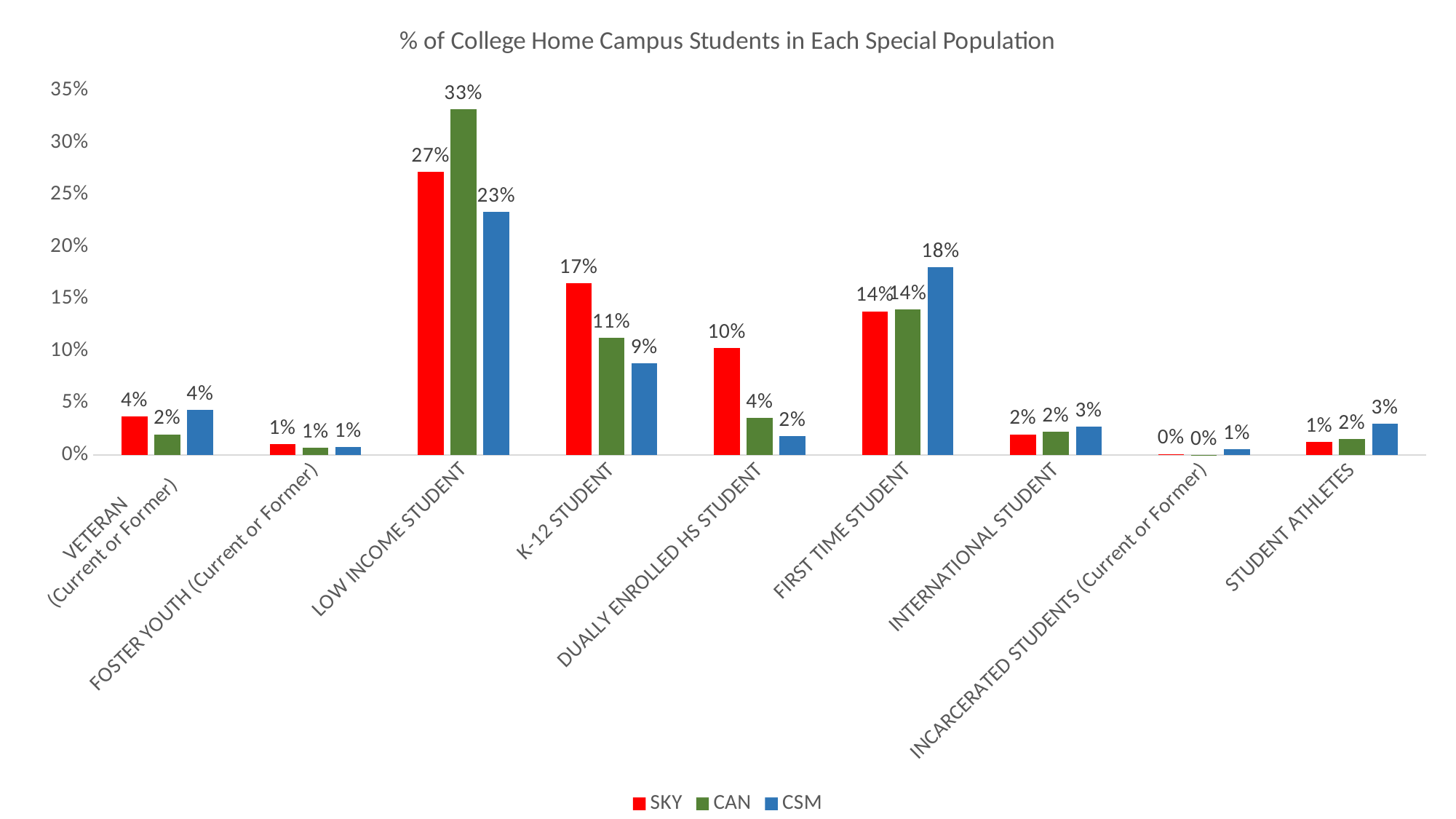
What is the difference between the CAN and CSM values for LOW INCOME STUDENT? 10% What is the SKY value for DUALLY ENROLLED HS STUDENT? 10% What is the CSM value for FIRST TIME STUDENT? 18% How many series does the legend list? 3 What is the CAN value for LOW INCOME STUDENT? 33% What is the difference between the SKY and CSM values for K-12 STUDENT? 8% For K-12 STUDENT, which is larger: the SKY value or the CAN value? SKY Which category has the highest CSM value? LOW INCOME STUDENT What type of chart is shown on the slide? Bar chart How many categories are shown on the x axis? 9 Which category has the lowest SKY value? INCARCERATED STUDENTS (Current or Former) Is the SKY value for LOW INCOME STUDENT greater or less than 25%? greater